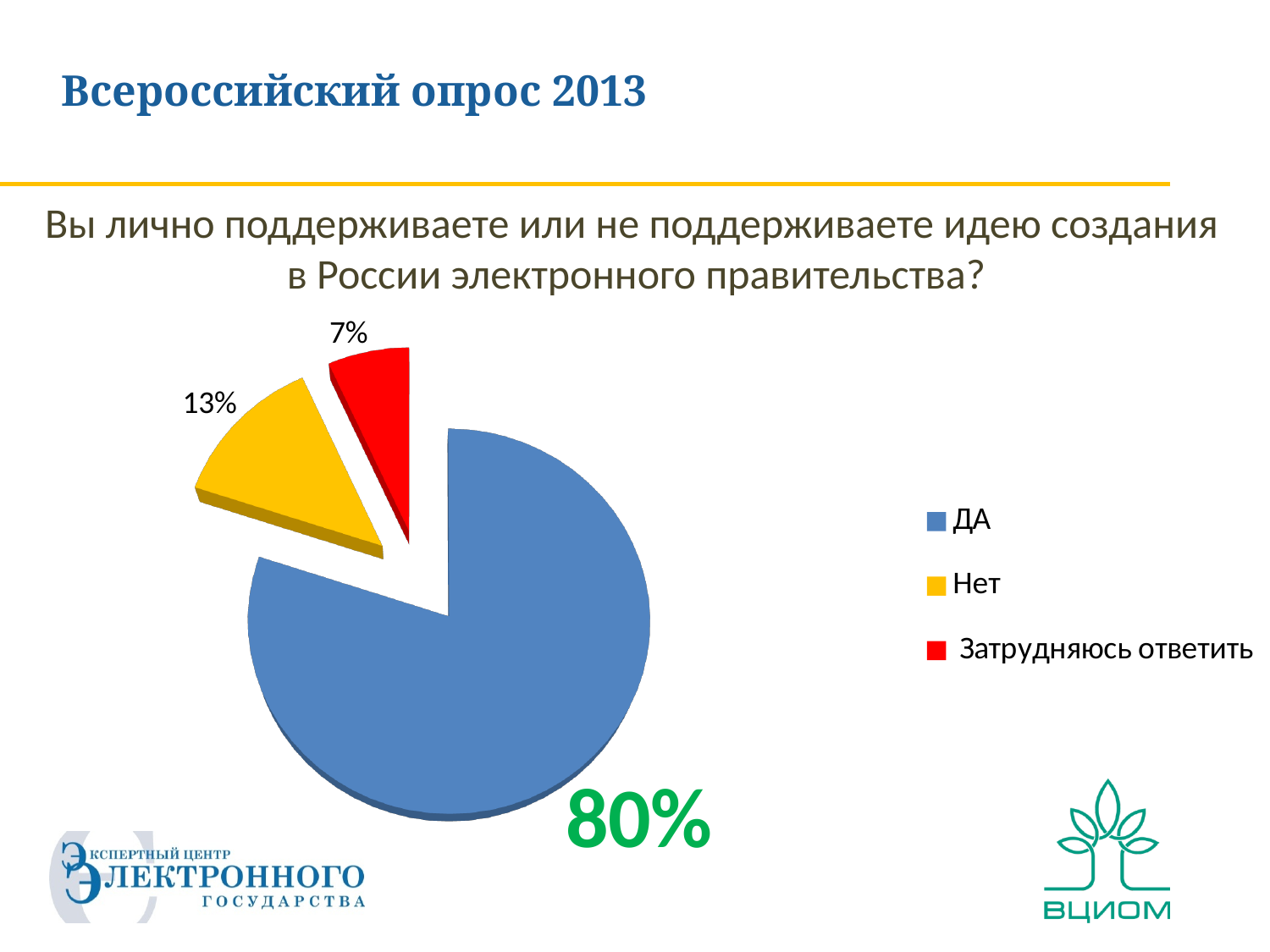
Which answer has the smallest share of the pie? Затрудняюсь ответить What percentage of respondents answered "Нет"? 13% Which is larger, the share for "Нет" or the share for "Затрудняюсь ответить"? Нет What kind of chart is shown on the slide? Pie chart Which answer has the largest share of the pie? ДА How many entries does the legend list? 3 What percentage of respondents answered "ДА"? 80% What percentage of respondents answered "Затрудняюсь ответить"? 7% What is the difference in percentage points between "ДА" and "Нет"? 67 What is the difference in percentage points between "Нет" and "Затрудняюсь ответить"? 6 What colour is the slice for "Нет"? Yellow How many slices does the pie chart have? 3